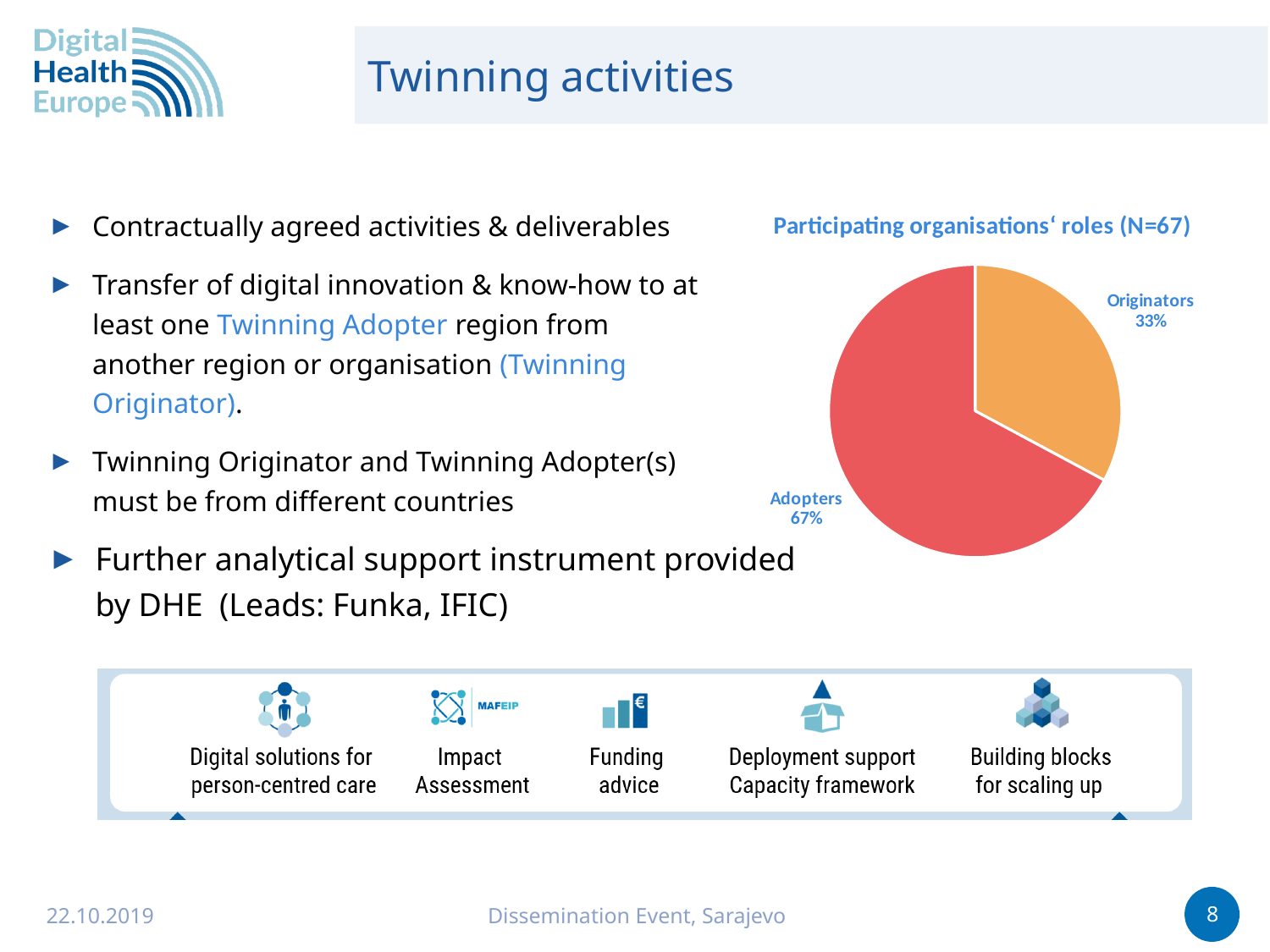
Which slice of the pie chart is the smallest? Originators What share of the pie chart do Originators represent? 33% What type of chart is shown on the slide? pie chart Which slice of the pie chart is the largest? Adopters How many slices does the pie chart have? 2 What is the total number of participating organisations (N) stated in the chart title? 67 Which is larger in the pie chart, Adopters or Originators? Adopters What is the title of the pie chart? Participating organisations' roles (N=67) What share of the pie chart do Adopters represent? 67% What is the difference in percentage points between the Adopters and Originators slices? 34